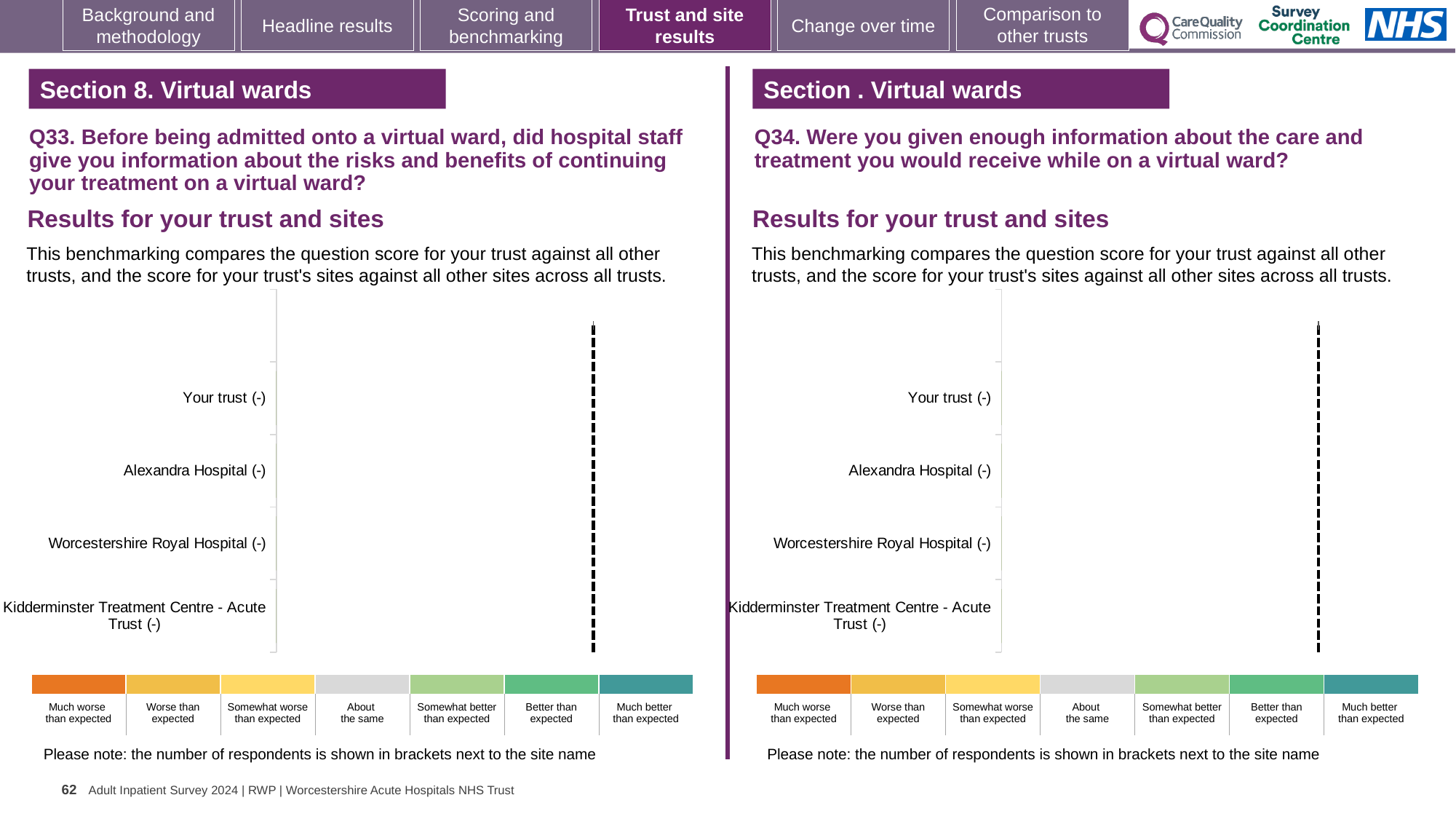
On the left chart (Q33), how many respondents are shown in brackets next to 'Your trust'? - On the left chart (Q33), how many categories are listed on the vertical axis? 4 On the right chart (Q34), what is shown in brackets next to 'Alexandra Hospital'? - On the right chart (Q34), how many categories are listed on the vertical axis? 4 On the left chart (Q33), how many colour bands does the legend below the chart list? 7 On the right chart (Q34), how many colour bands does the legend below the chart list? 7 On the left chart (Q33), which category is listed last (at the bottom) on the vertical axis? Kidderminster Treatment Centre - Acute Trust (-) On the right chart (Q34), what label does the legend give to the leftmost (orange) band? Much worse than expected